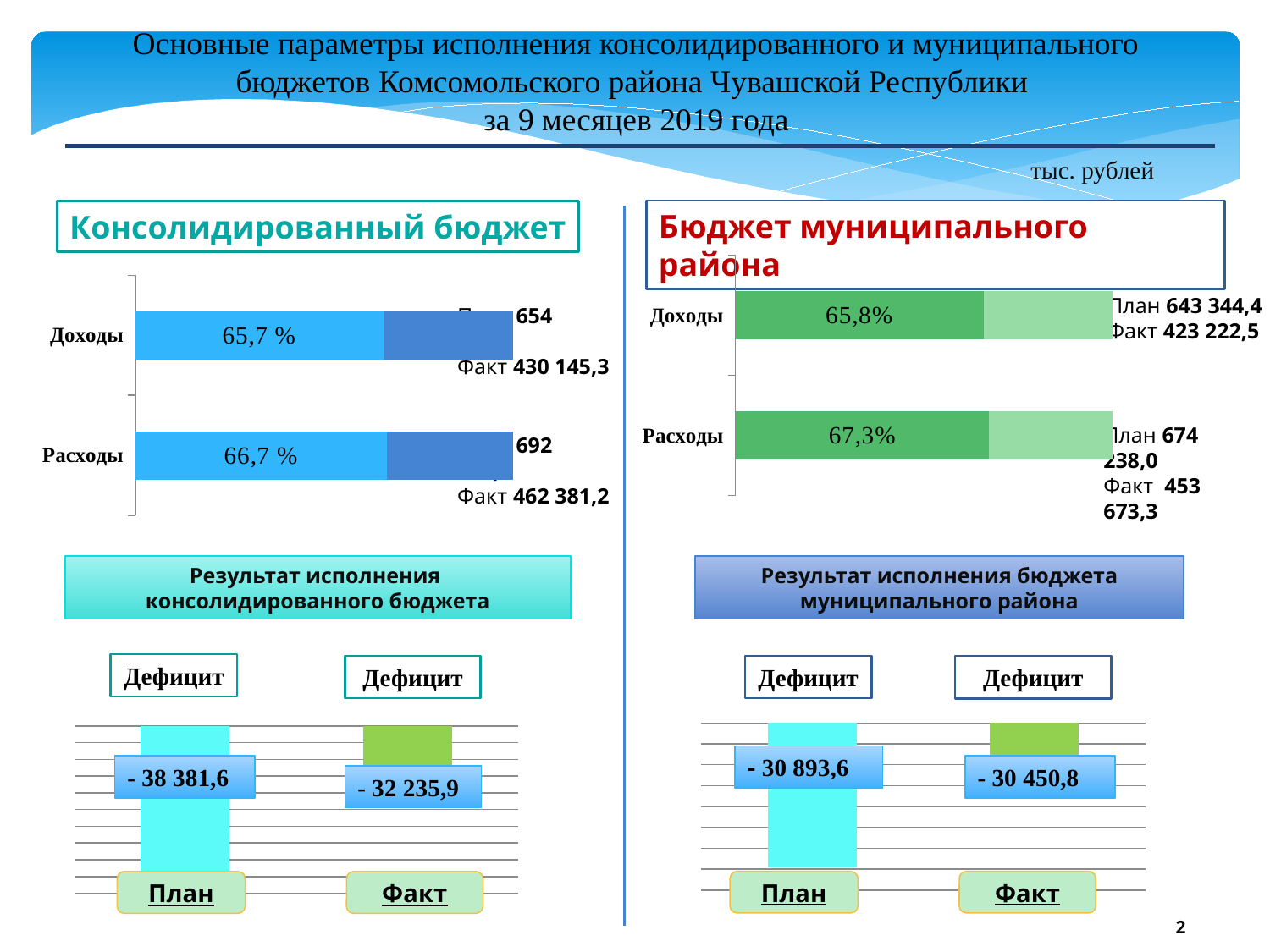
In the 'Бюджет муниципального района' chart, which category has the higher execution percentage, Доходы or Расходы? Расходы In the 'Бюджет муниципального района' chart, what is the difference between the План and Факт values for Доходы? 220 121,9 In the 'Консолидированный бюджет' chart, what is the Факт value for Доходы? 430 145,3 In the 'Бюджет муниципального района' chart, what percentage is shown on the Доходы bar? 65,8% In the 'Консолидированный бюджет' chart, what percentage is shown on the Расходы bar? 66,7 % In the 'Бюджет муниципального района' chart, what is the План value for Доходы? 643 344,4 What type of chart is the 'Консолидированный бюджет' chart? bar chart In the 'Консолидированный бюджет' chart, what is the difference between the Факт values for Расходы and Доходы? 32 235,9 In the 'Бюджет муниципального района' chart, what is the Факт value for Расходы? 453 673,3 In the 'Результат исполнения бюджета муниципального района' chart at the bottom right, what is the Факт deficit value? - 30 450,8 In the 'Результат исполнения консолидированного бюджета' chart at the bottom left, what is the План deficit value? - 38 381,6 In the 'Консолидированный бюджет' chart, what is the Факт value for Расходы? 462 381,2